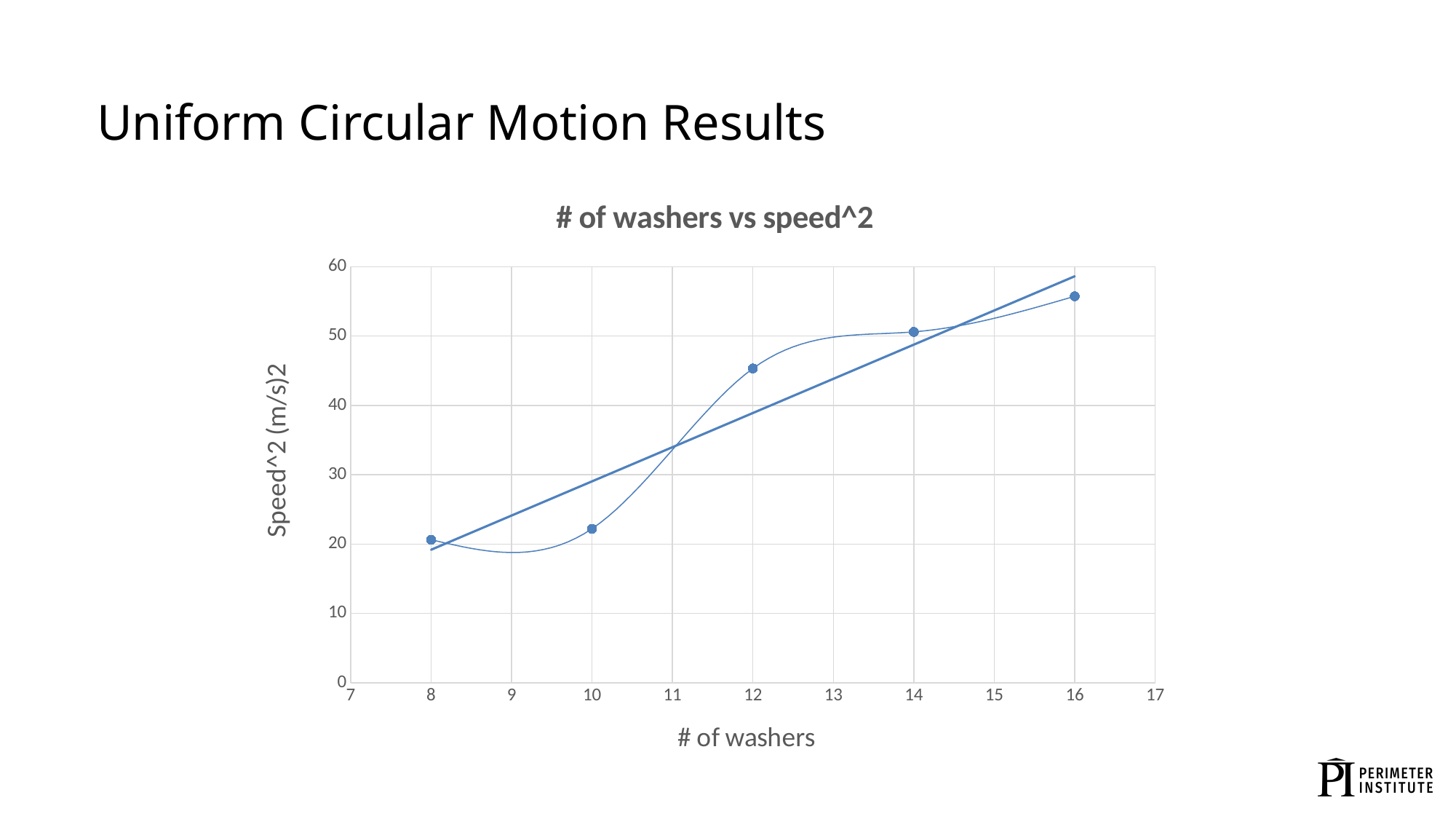
Do the plotted values rise or fall as the number of washers increases? rise Is the value for 10 washers greater or less than 30? less How many data points are plotted on the chart? 5 What is the title of the chart? # of washers vs speed^2 Is the value for 16 washers greater or less than 50? greater What kind of chart is shown on the slide? scatter chart with a trendline At which number of washers is speed^2 highest? 16 Which has the larger speed^2 value: 10 washers or 12 washers? 12 washers Is the value for 12 washers greater or less than 40? greater What is the label of the x axis? # of washers Which has the larger speed^2 value: 12 washers or 14 washers? 14 washers